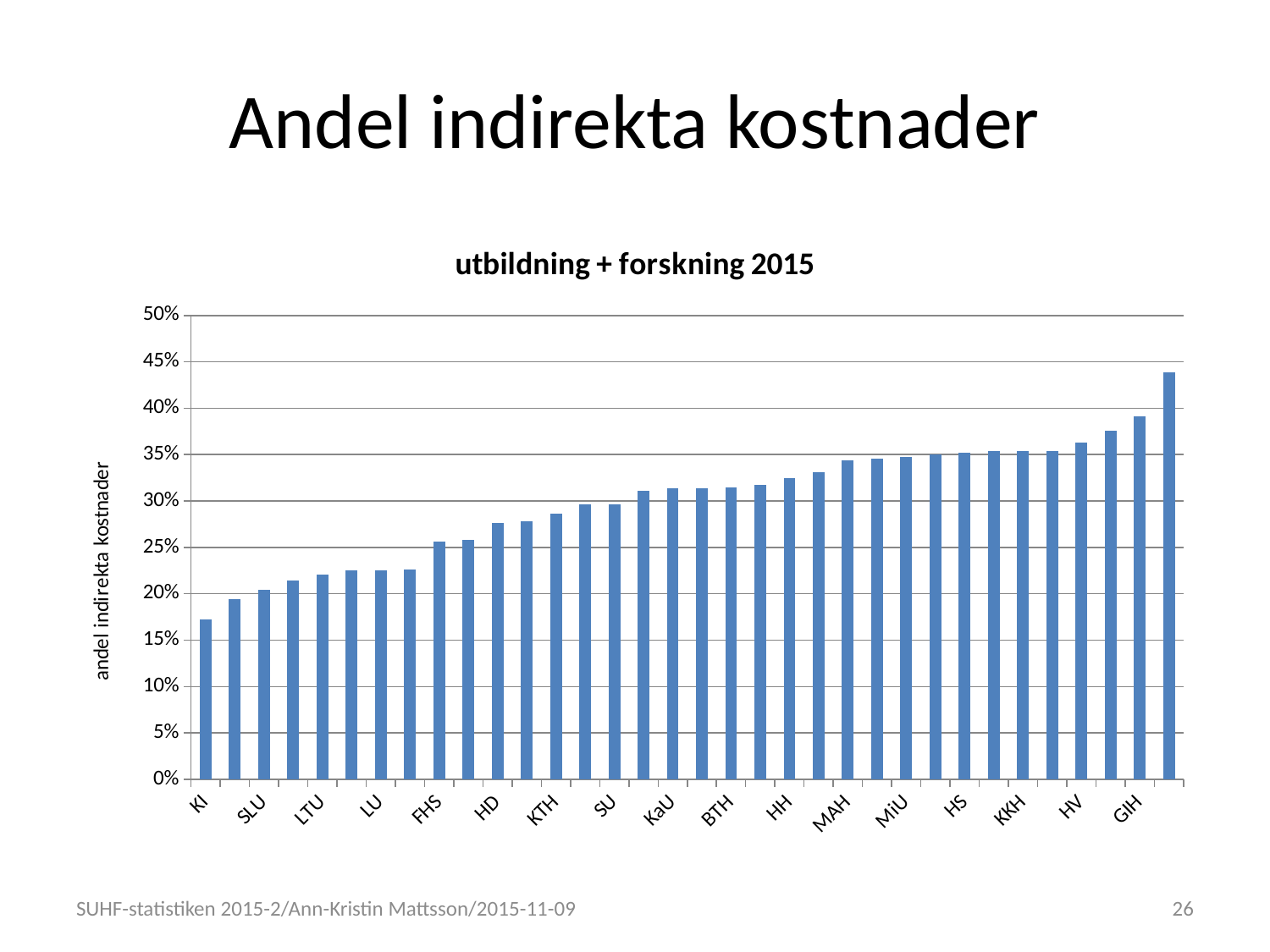
Is the value for KTH greater or less than 30%? less What is the label on the vertical axis of the chart? andel indirekta kostnader Is the value for HH greater or less than 30%? greater Which labeled category has the lowest value in the chart? KI Do the values rise or fall from left to right along the x axis? rise What kind of chart is shown on the slide? bar chart Is the value for HD greater or less than 25%? greater Which has the larger value, GIH or KI? GIH What is the title of the chart? utbildning + forskning 2015